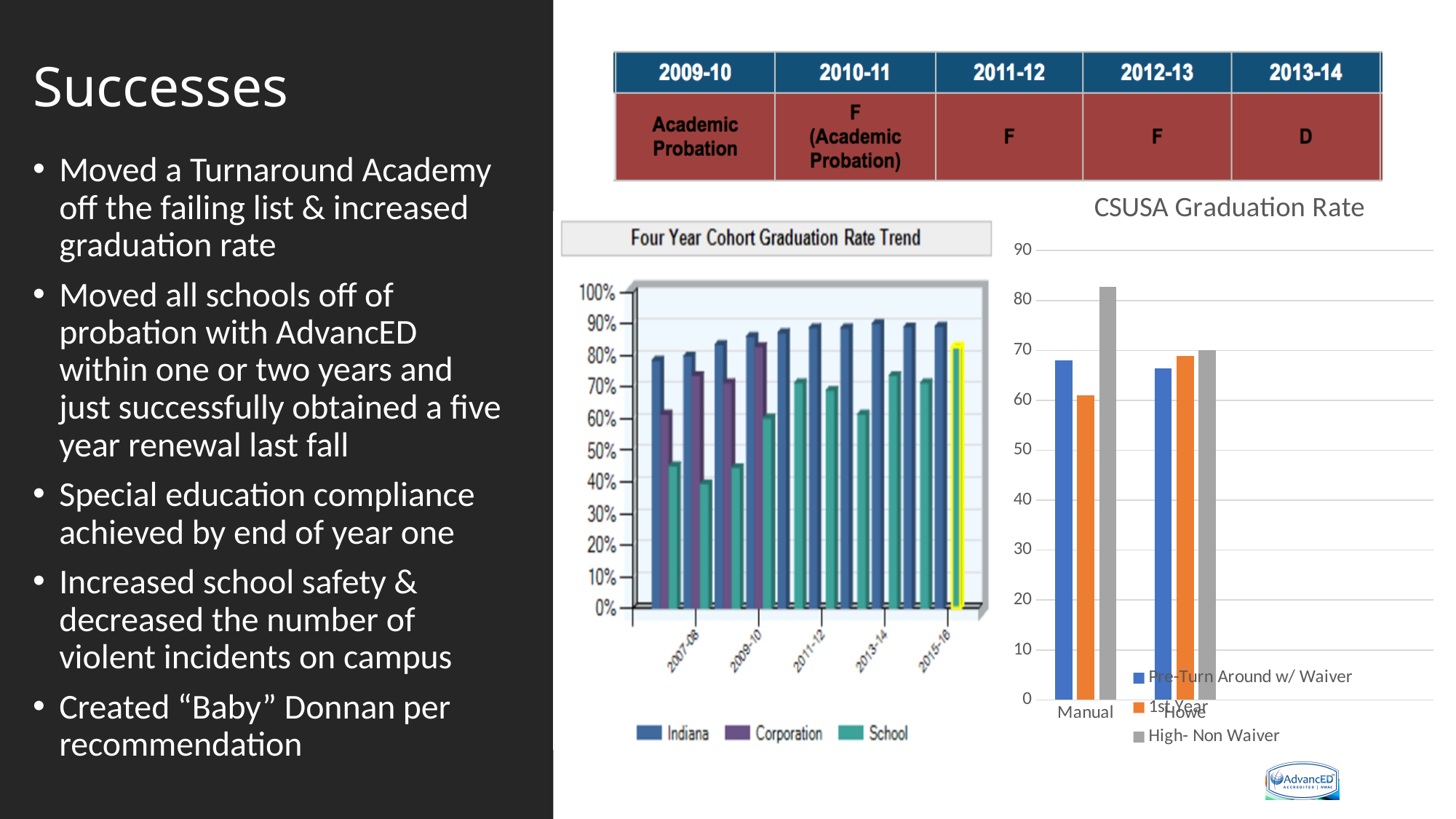
How many categories are shown on the x axis of the CSUSA Graduation Rate chart? 2 How many series does the legend of the Four Year Cohort Graduation Rate Trend chart list? 3 In the CSUSA Graduation Rate chart, is the Pre-Turn Around w/ Waiver value for Howe greater or less than 70? less In the Four Year Cohort Graduation Rate Trend chart, is the School value for 2007-08 greater or less than 50%? less In the Four Year Cohort Graduation Rate Trend chart, which series is shown in green? School In the CSUSA Graduation Rate chart, which series has the lowest value for Manual? 1st Year What kind of chart is the CSUSA Graduation Rate chart? bar chart In the CSUSA Graduation Rate chart, is the High- Non Waiver value for Manual greater or less than 80? greater In the CSUSA Graduation Rate chart, which series has the highest value for Manual? High- Non Waiver In the CSUSA Graduation Rate chart, which is larger for Howe: Pre-Turn Around w/ Waiver or High- Non Waiver? High- Non Waiver How many series does the legend of the CSUSA Graduation Rate chart list? 3